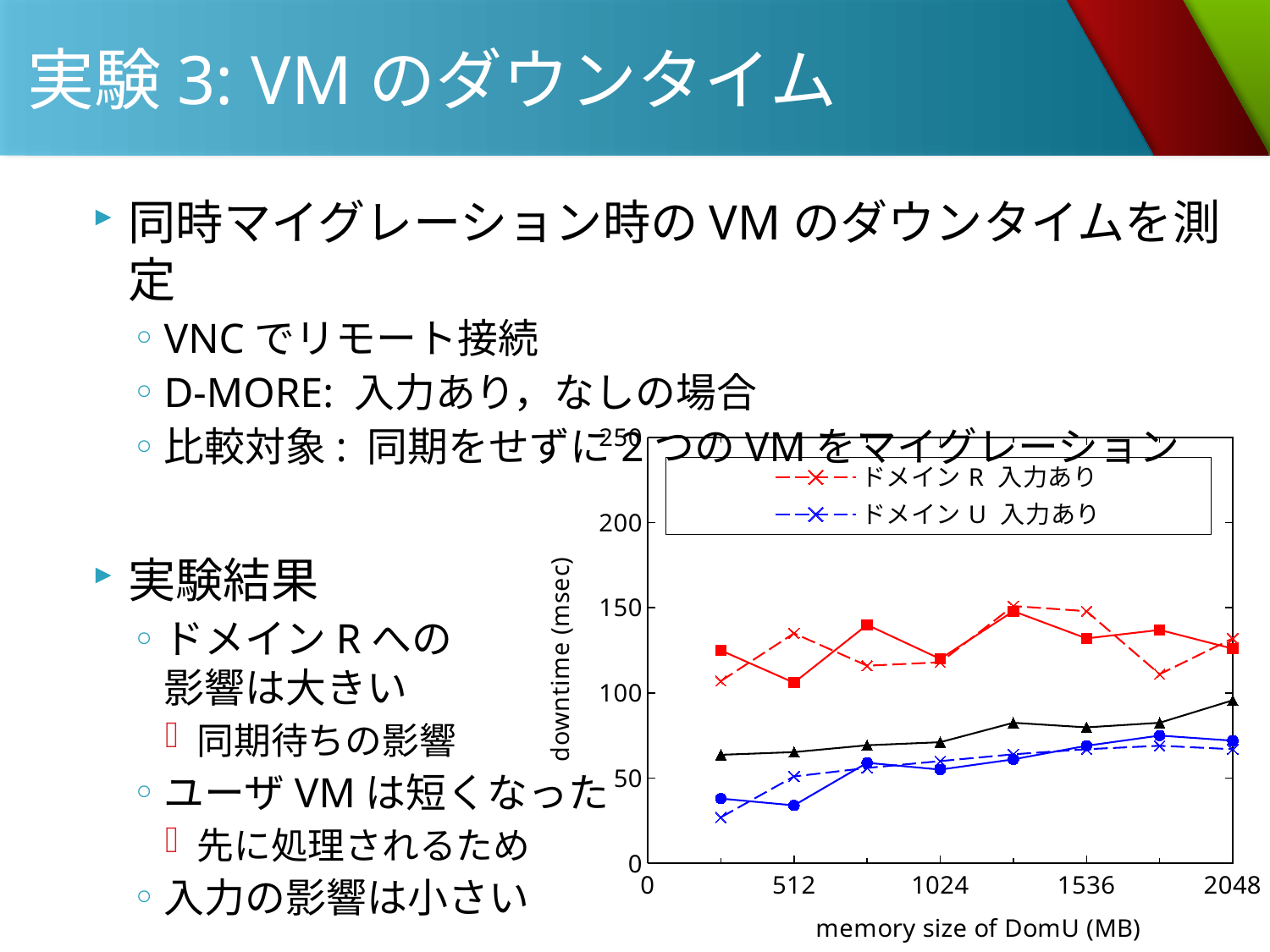
How many series does the visible legend list? 2 Is the value for ドメイン U 入力あり at memory size 256 MB greater or less than 50? less What kind of chart is shown on the slide? line chart Is the value for ドメイン R 入力あり at memory size 1024 MB greater or less than 150? less What is the label of the y axis? downtime (msec) At memory size 1024 MB, which series has the larger downtime, ドメイン R 入力あり or ドメイン U 入力あり? ドメイン R 入力あり How many data points are plotted for the ドメイン U 入力あり series? 8 Is the value for ドメイン R 入力あり at memory size 512 MB greater or less than 100? greater Does the downtime for ドメイン U 入力あり generally rise or fall as memory size increases? rise What is the label of the x axis? memory size of DomU (MB) What colour is the ドメイン R 入力あり series in the legend? red